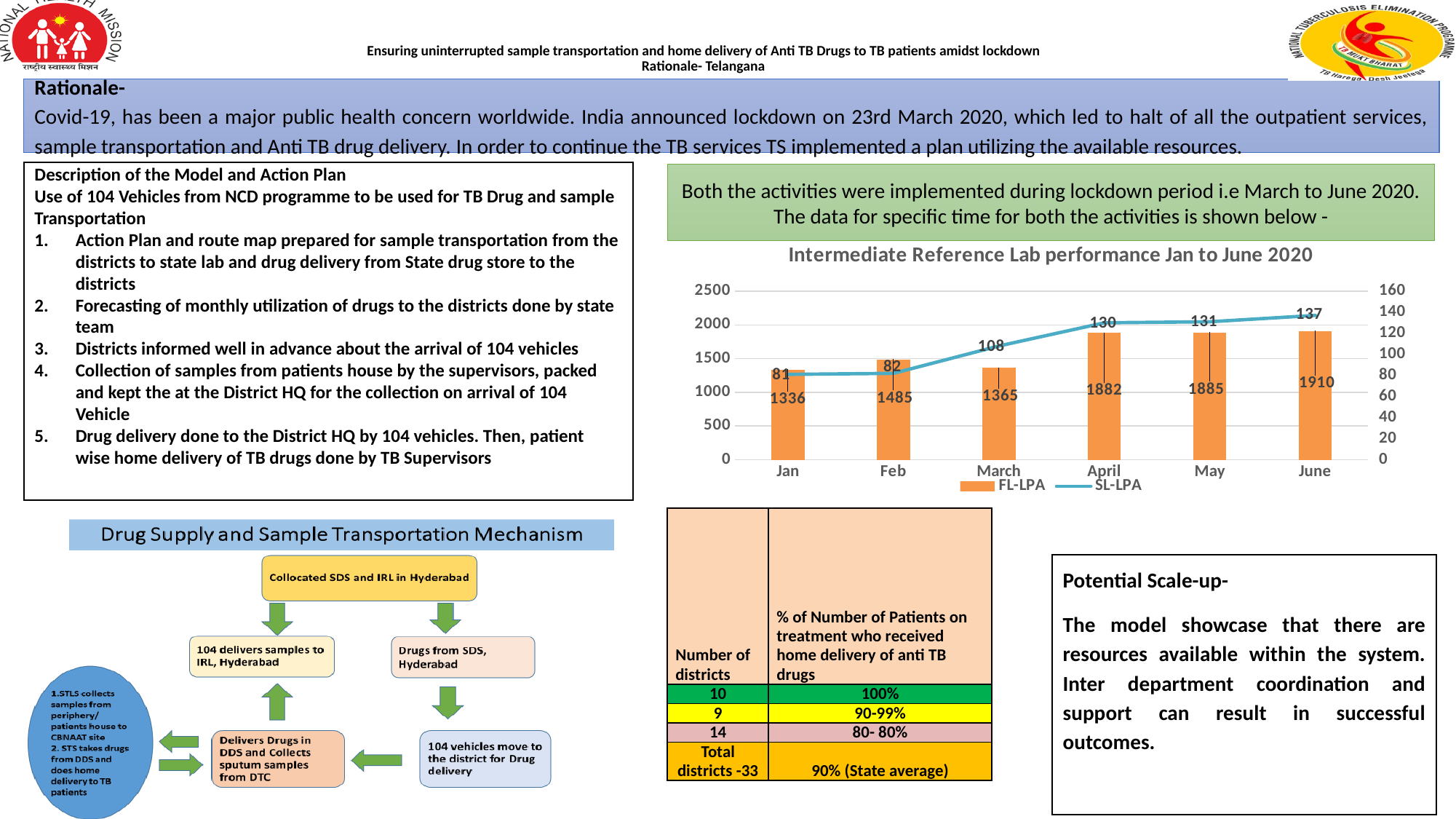
How many months are shown on the x axis of the chart? 6 Which is larger, the FL-LPA value for Feb or for March? Feb What is the difference between the FL-LPA values for June and Jan? 574 Which month has the lowest SL-LPA value? Jan How many series does the chart legend list? 2 What is the FL-LPA value for April? 1882 Does the SL-LPA line rise or fall from Jan to June? rise Is the FL-LPA value for May greater or less than 1500? greater Which month has the highest FL-LPA value? June What is the title of the chart? Intermediate Reference Lab performance Jan to June 2020 What is the SL-LPA value for March? 108 What kind of chart is used to show the FL-LPA series? bar chart